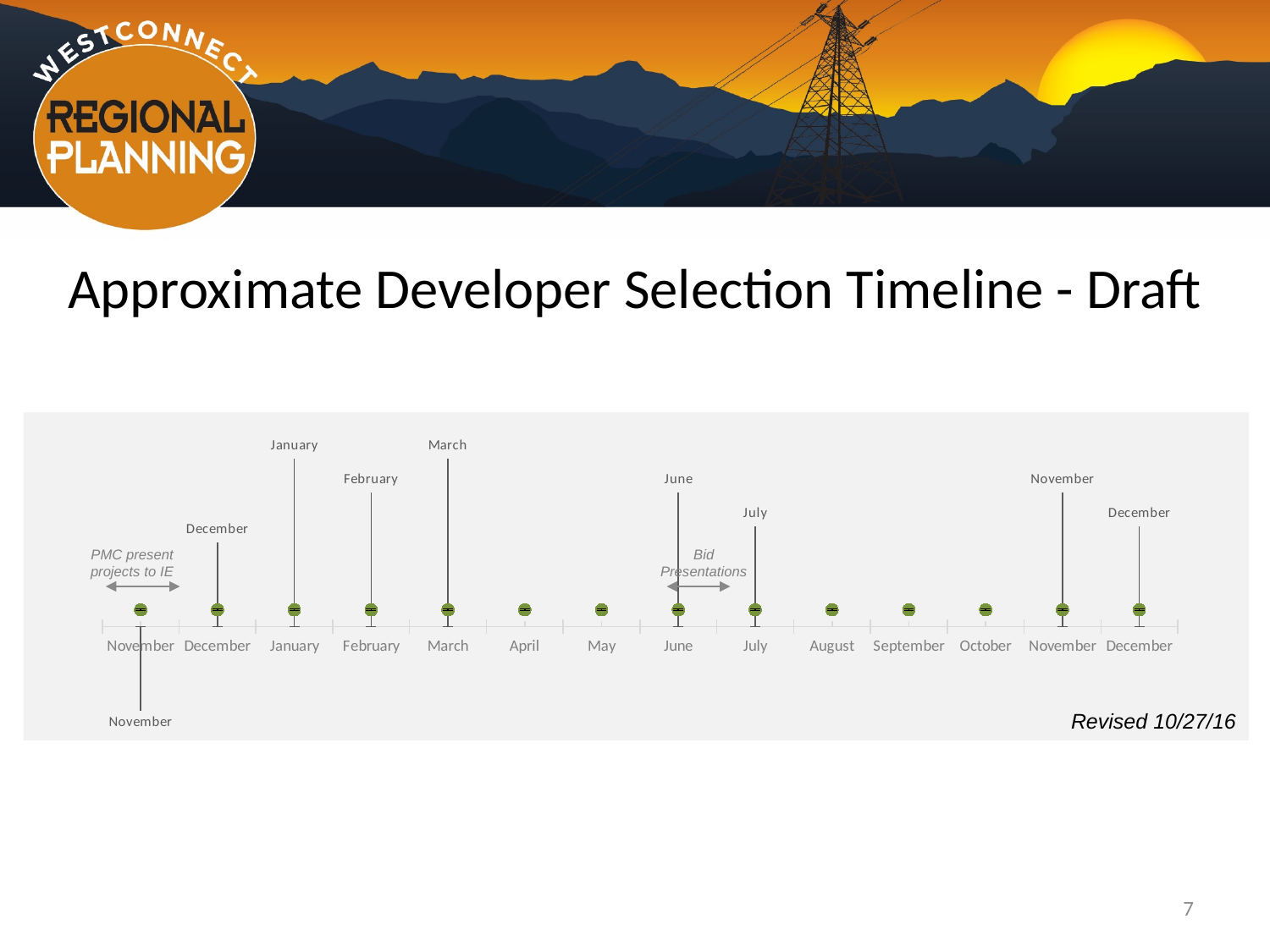
What annotation is shown between the June and July markers on the timeline? Bid Presentations What is the last month shown on the timeline axis? December How many months on the timeline have a vertical line with a label above the axis? 8 How many month labels are shown along the timeline axis? 14 Which month label is placed below the timeline axis rather than above it? November What is the title of the timeline on the slide? Approximate Developer Selection Timeline - Draft What annotation is shown near the November marker at the start of the timeline? PMC present projects to IE What kind of chart is shown on the slide? Timeline chart What is the first month shown on the timeline axis? November